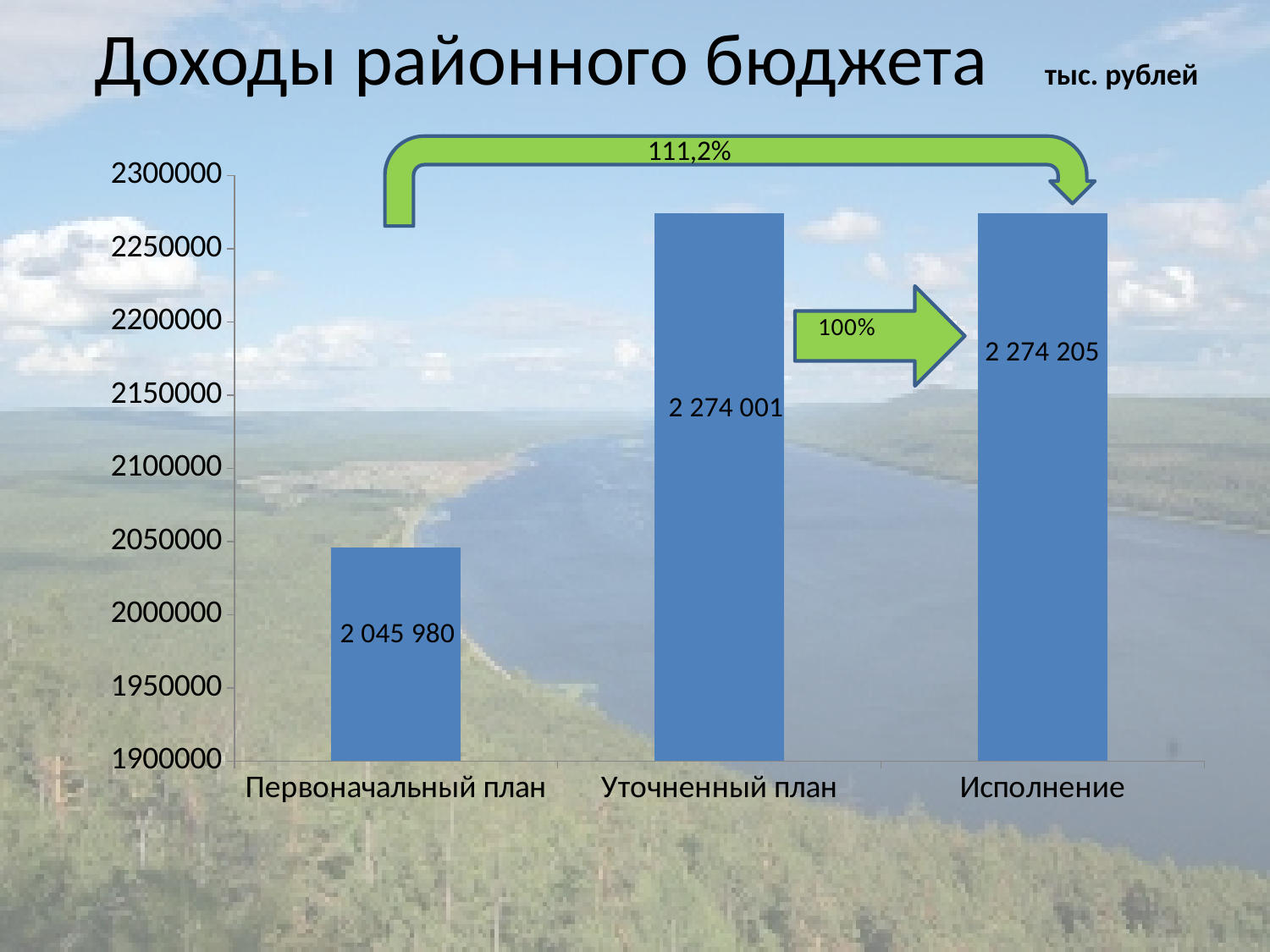
What is the value for Уточненный план? 2 274 001 What is the title of the chart? Доходы районного бюджета What kind of chart is shown on the slide? bar chart Which is larger, Первоначальный план or Уточненный план? Уточненный план What is the difference between Исполнение and Уточненный план? 204 What is the value for Первоначальный план? 2 045 980 What is the value for Исполнение? 2 274 205 Which category has the lowest value? Первоначальный план Is the value for Первоначальный план greater or less than 2000000? greater What is the difference between Уточненный план and Первоначальный план? 228 021 How many categories are shown on the chart? 3 Is the value for Уточненный план greater or less than 2250000? greater